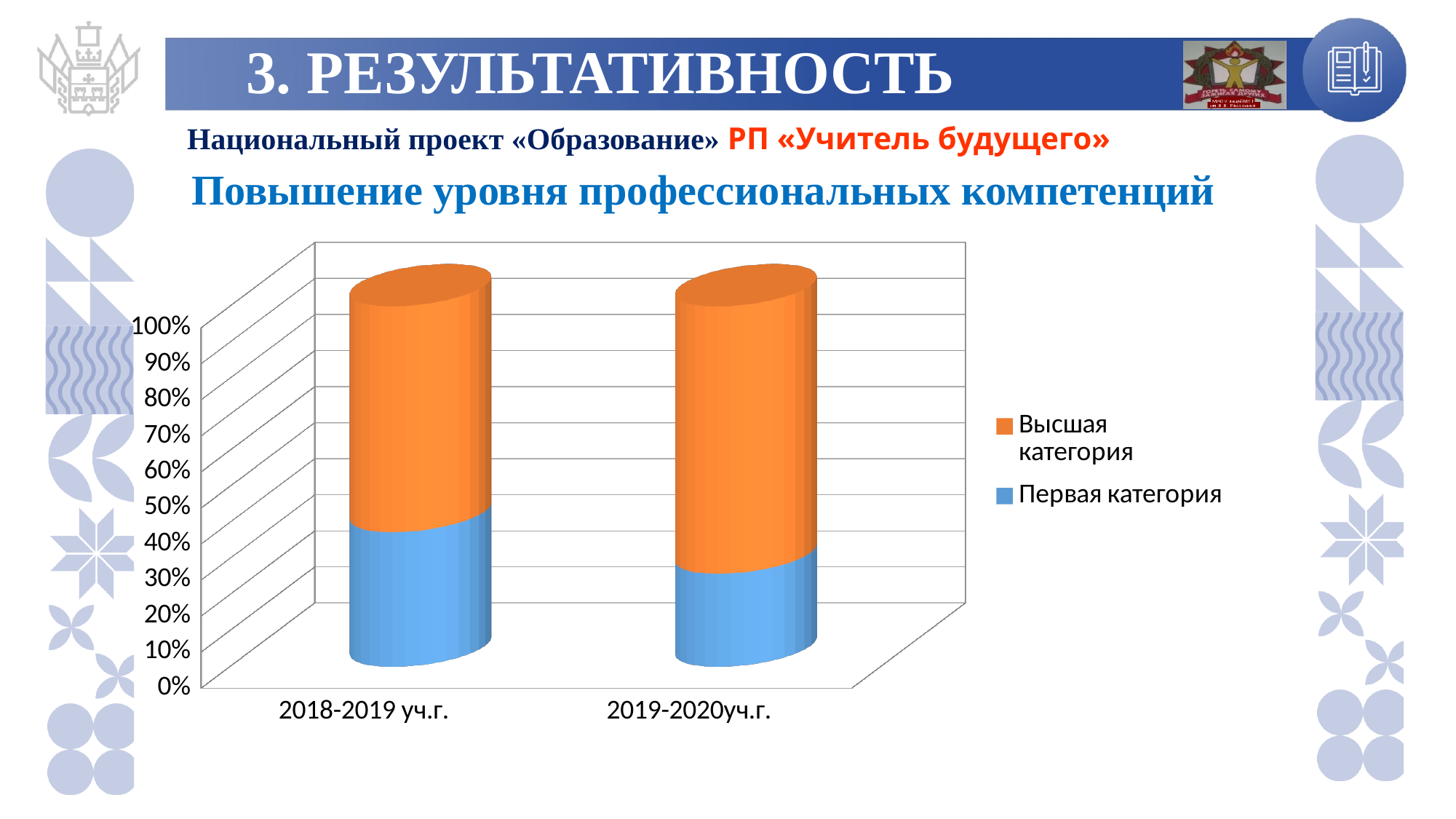
Which series is shown in blue in the chart? Первая категория Is the value for Первая категория in 2019-2020уч.г. greater or less than 20%? greater Is the value for Первая категория in 2018-2019 уч.г. greater or less than 60%? less Is the value for Первая категория in 2019-2020уч.г. greater or less than 50%? less How many series does the chart legend list? 2 Does the share of Высшая категория rise or fall from 2018-2019 уч.г. to 2019-2020уч.г.? rise What kind of chart is shown on the slide? bar chart Which year has the larger share for Первая категория, 2018-2019 уч.г. or 2019-2020уч.г.? 2018-2019 уч.г. How many categories are shown on the x axis of the chart? 2 Which series is shown in orange in the chart? Высшая категория Does the share of Первая категория rise or fall from 2018-2019 уч.г. to 2019-2020уч.г.? fall